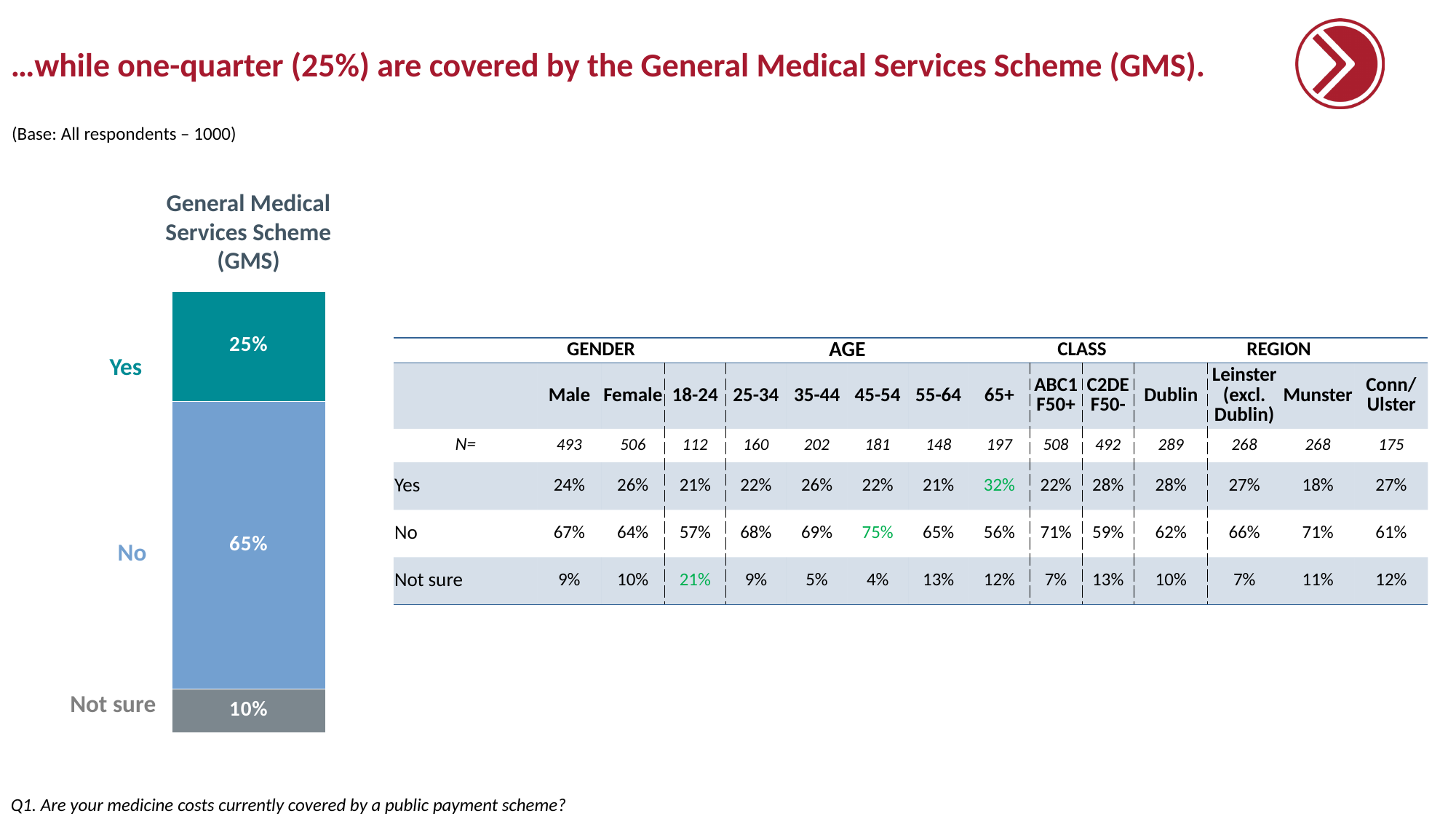
What percentage of respondents answered No in the GMS chart? 65% Which response has the smallest share in the GMS chart? Not sure What is the total of the three segments in the GMS stacked bar? 100% What kind of chart is used to show the GMS responses? Stacked bar chart What percentage of respondents answered Yes in the General Medical Services Scheme (GMS) chart? 25% What percentage of respondents answered Not sure in the GMS chart? 10% Which is larger in the GMS chart, the Yes share or the Not sure share? Yes Which response has the largest share in the GMS chart? No What is the title of the chart on the slide? General Medical Services Scheme (GMS) What colour is the Yes segment in the GMS chart? Teal How many response categories are shown in the GMS chart? 3 What is the difference between the No and Yes percentages in the GMS chart? 40%